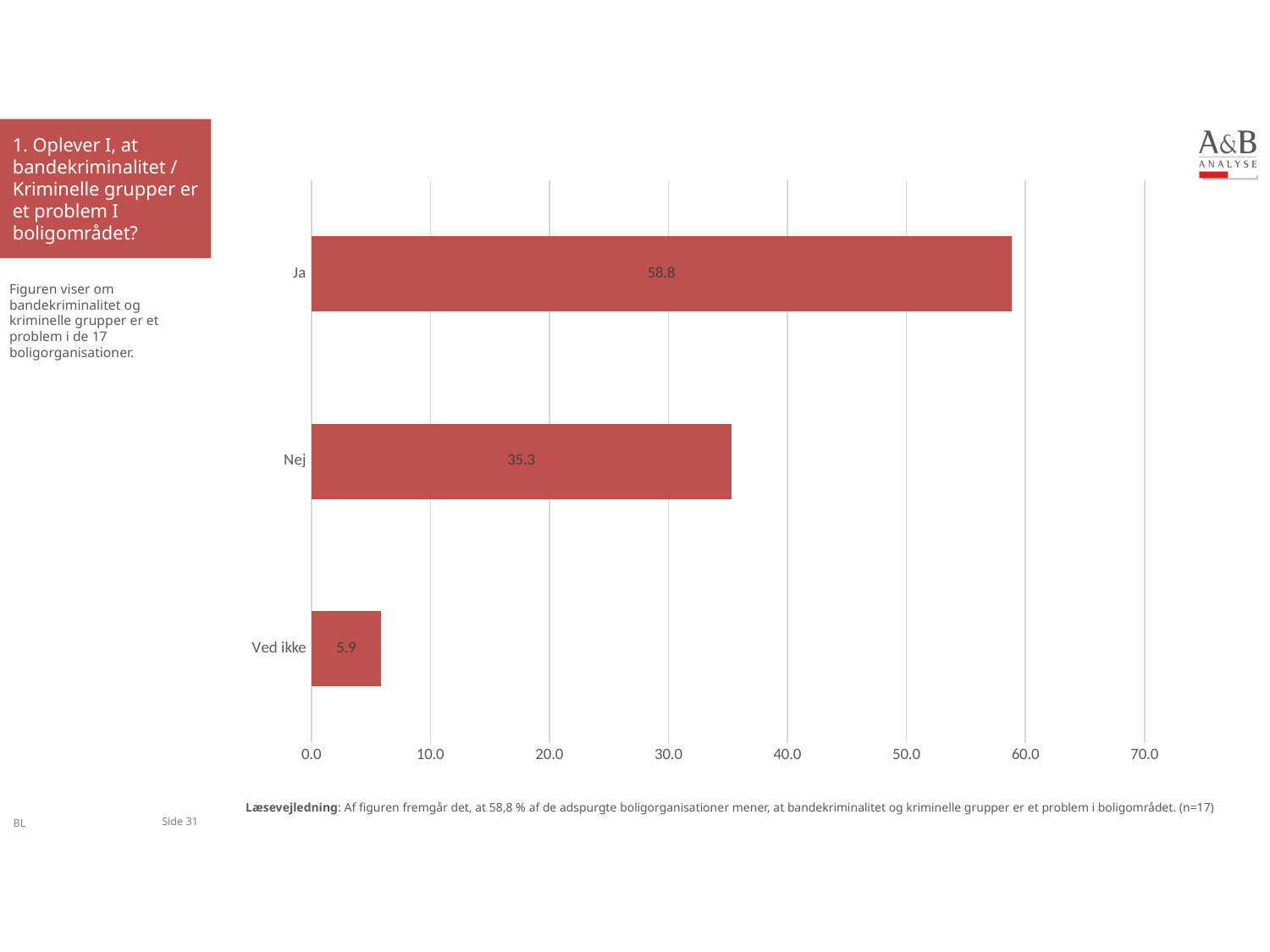
Is the value for "Ja" greater or less than 50.0? greater What is the value for "Ved ikke"? 5.9 Which category has the lowest value? Ved ikke What is the difference between the values for "Nej" and "Ved ikke"? 29.4 What is the difference between the values for "Ja" and "Nej"? 23.5 Which category has the highest value? Ja What is the value for "Ja"? 58.8 What is the highest value shown on the x axis? 70.0 What is the value for "Nej"? 35.3 How many categories are shown in the chart? 3 Which is larger, the value for "Nej" or the value for "Ved ikke"? Nej What kind of chart is shown on the slide? Bar chart